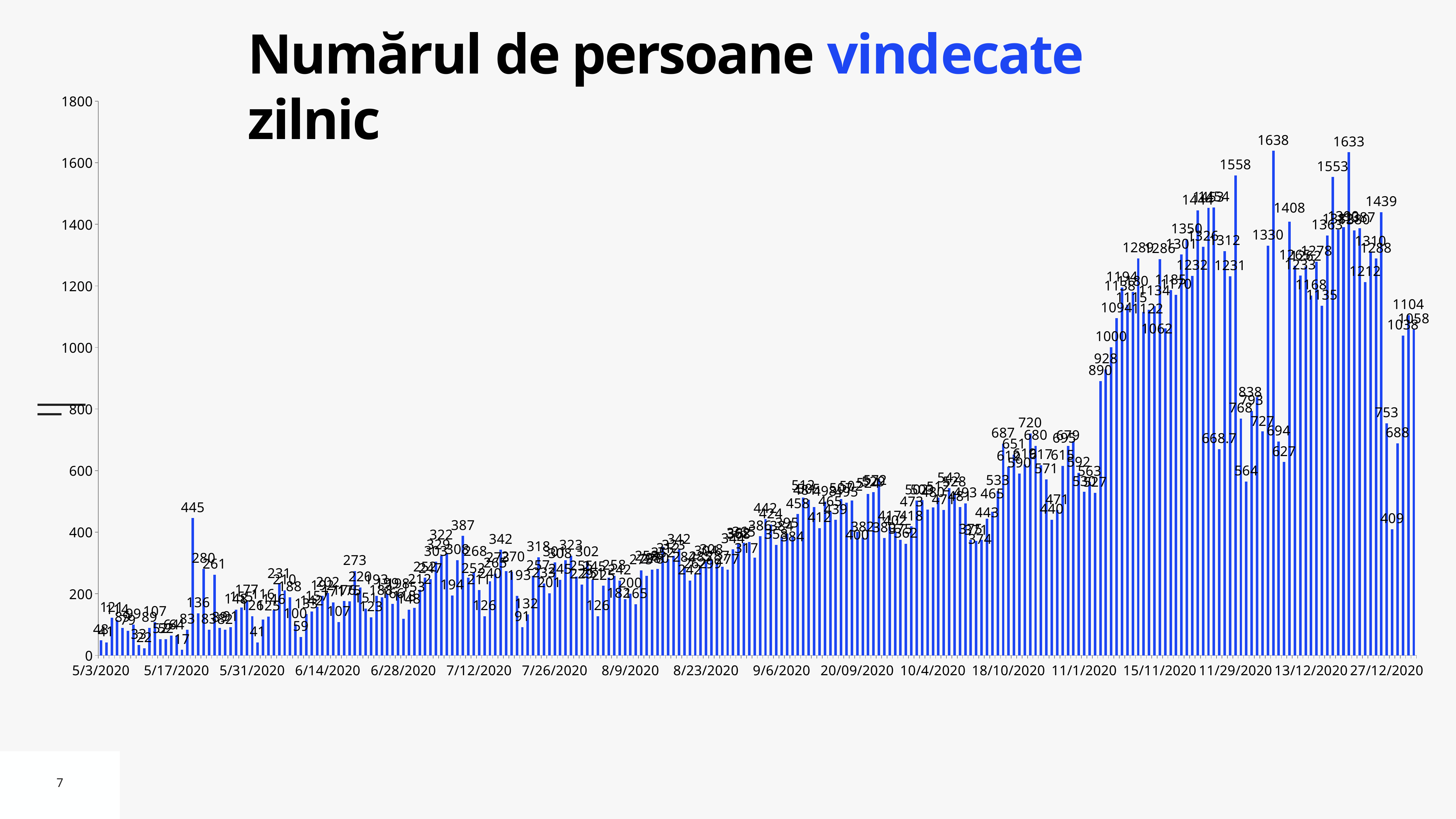
What is the difference between the two highest labelled values, 1638 and 1633? 5 What is the highest daily value labelled on the chart? 1638 Do the values generally rise or fall from left to right along the x axis? rise Which is larger, the bar labelled 445 or the bar labelled 387? 445 Is the last (rightmost) bar greater or less than 1000? greater Is the first bar, at 5/3/2020, greater or less than 200? less Is the tallest bar greater or less than 1600? greater What kind of chart is shown on the slide? bar chart What is the title of the chart? Numărul de persoane vindecate zilnic What is the difference between the highest labelled value (1638) and the value 1558? 80 What colour are the bars in the chart? blue What is the lowest daily value labelled on the chart? 17